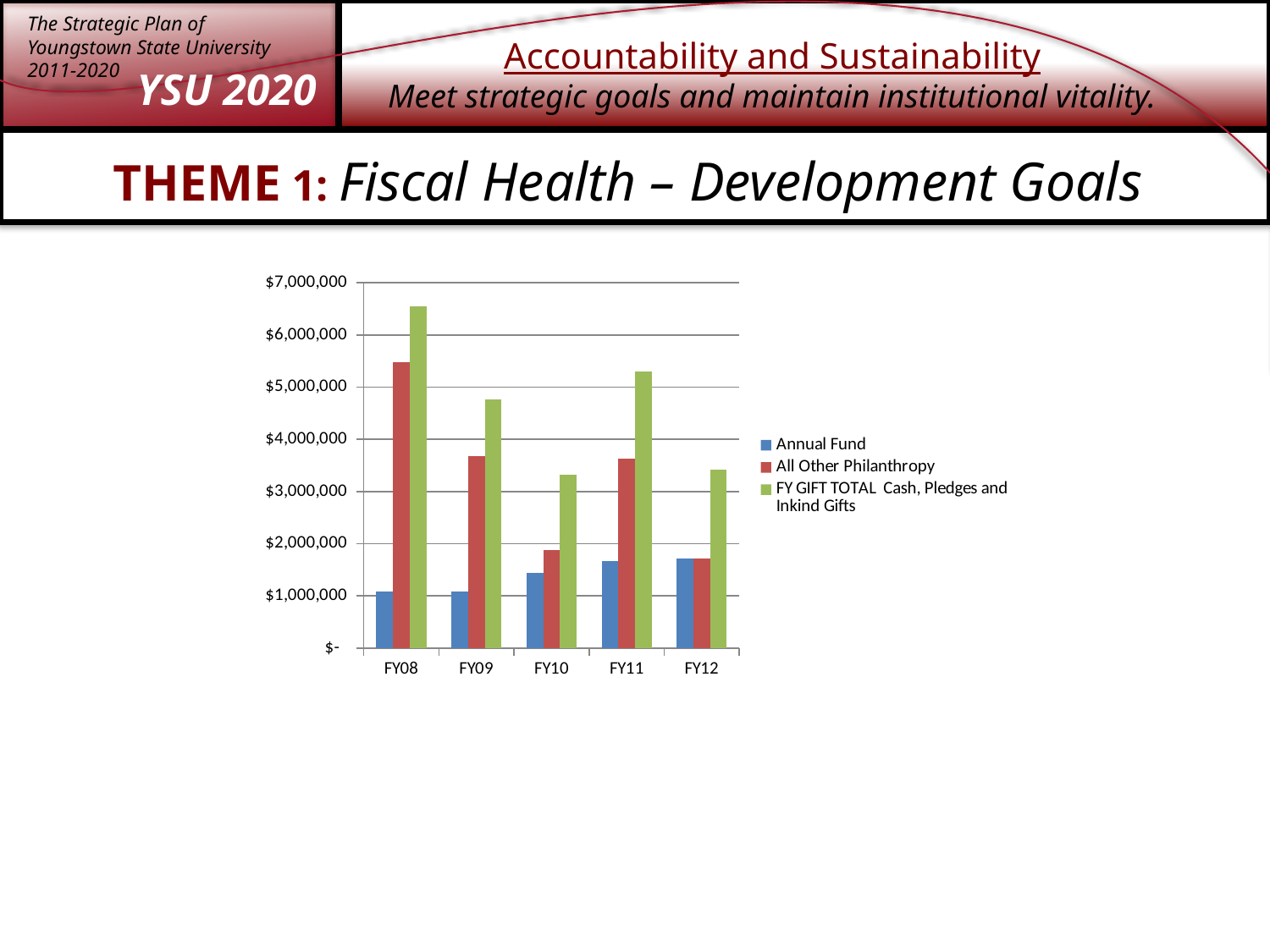
Is the FY GIFT TOTAL Cash, Pledges and Inkind Gifts value for FY11 greater or less than $5,000,000? greater Is the FY GIFT TOTAL Cash, Pledges and Inkind Gifts value for FY08 greater or less than $6,000,000? greater What kind of chart is shown on the slide? bar chart How many series does the legend list? 3 In which fiscal year is the All Other Philanthropy value highest? FY08 Which fiscal year has the larger All Other Philanthropy value, FY10 or FY11? FY11 Which fiscal year has the larger FY GIFT TOTAL Cash, Pledges and Inkind Gifts value, FY09 or FY12? FY09 How many fiscal years are shown on the x axis? 5 In which fiscal year is the FY GIFT TOTAL Cash, Pledges and Inkind Gifts value highest? FY08 What colour represents the FY GIFT TOTAL Cash, Pledges and Inkind Gifts series in the legend? green Does the Annual Fund value rise or fall from FY08 to FY12? rise Is the Annual Fund value for FY10 greater or less than $2,000,000? less